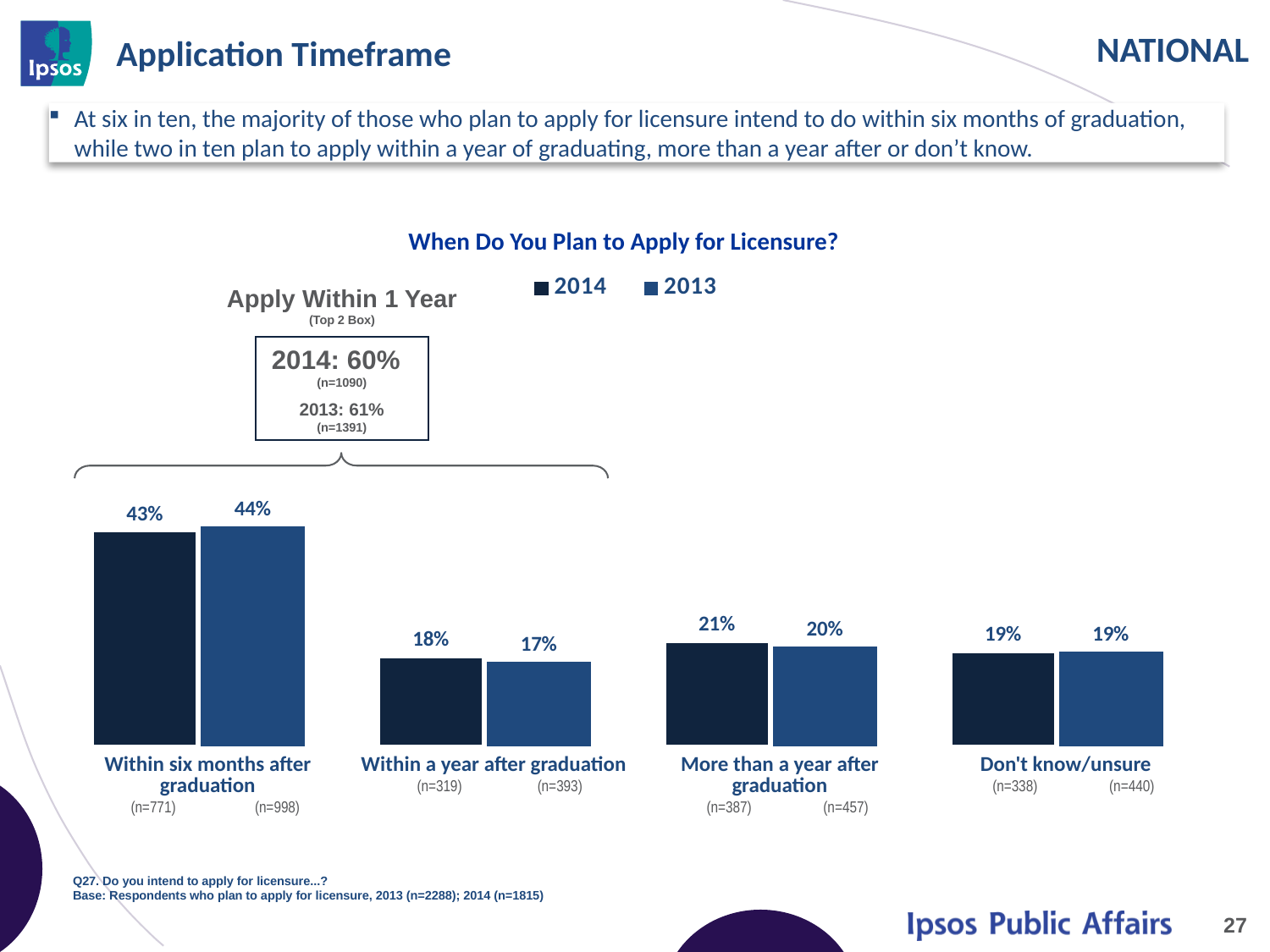
Which category has the lowest value for the 2013 series? Within a year after graduation Which category has the highest value for the 2014 series? Within six months after graduation What percentage of 2014 respondents plan to apply within six months after graduation? 43% What percentage of 2013 respondents answered 'Don't know/unsure'? 19% What is the difference between the 2014 and 2013 values for 'Within a year after graduation'? 1% What is the 2013 value for 'Within a year after graduation'? 17% What is the title of the chart? When Do You Plan to Apply for Licensure? How many categories are shown on the x axis of the chart? 4 What type of chart is shown on the slide? Bar chart For 'Within six months after graduation', which series has the larger value, 2014 or 2013? 2013 What is the 2014 value for 'More than a year after graduation'? 21% How many series does the chart legend list? 2